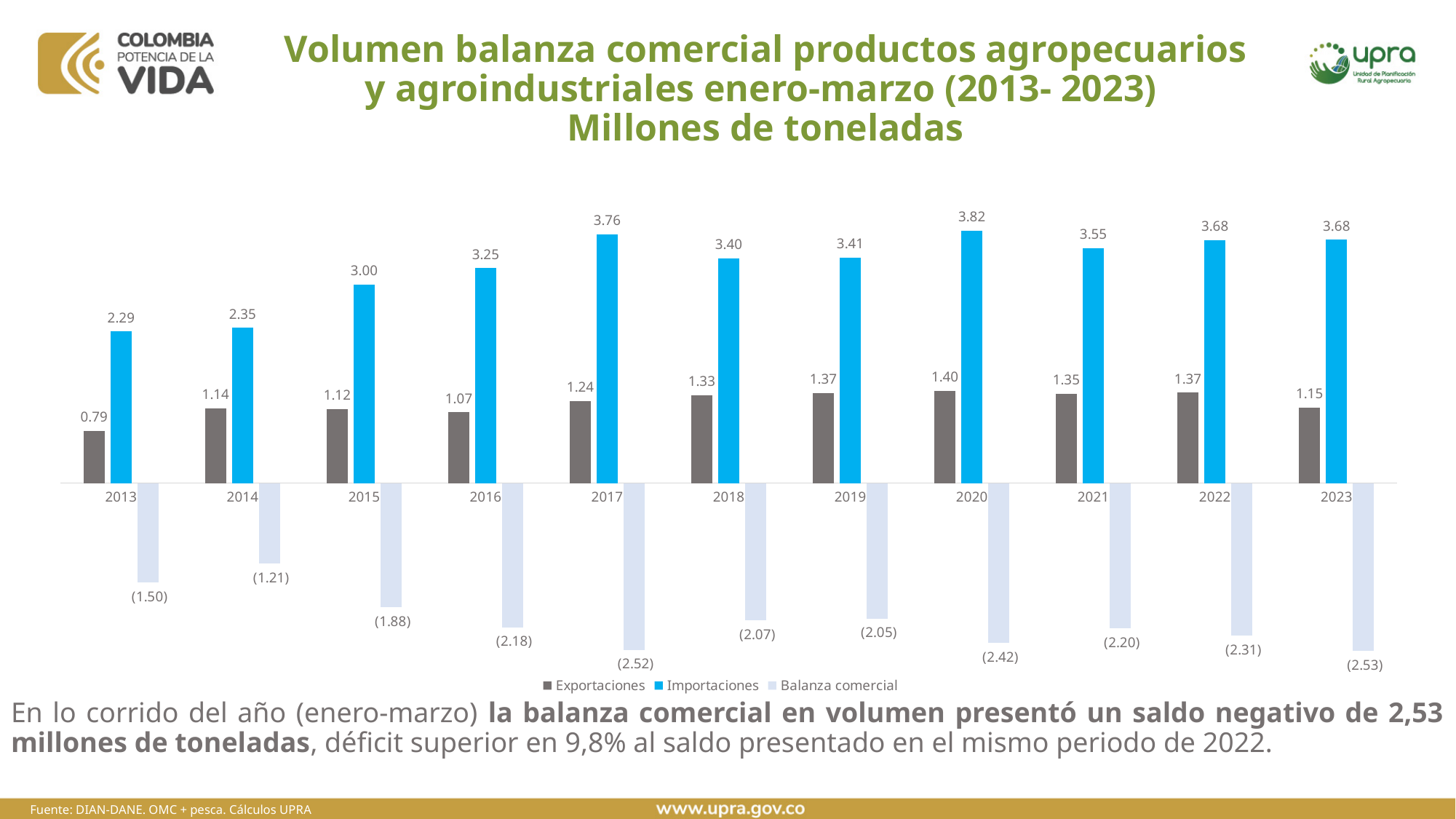
Which is larger, Exportaciones in 2020 or Exportaciones in 2023? Exportaciones in 2020 Which series is shown in blue in the legend? Importaciones What is the value of Importaciones in 2020? 3.82 Do the Importaciones values rise or fall from 2013 to 2017? Rise How many series does the legend list? 3 What is the value of Exportaciones in 2013? 0.79 What is the value of Balanza comercial in 2023? (2.53) What is the difference between Importaciones and Exportaciones in 2017? 2.52 Which year has the lowest Exportaciones value? 2013 How many years are shown on the x axis? 11 What kind of chart is shown on the slide? Bar chart Which year has the highest Importaciones value? 2020